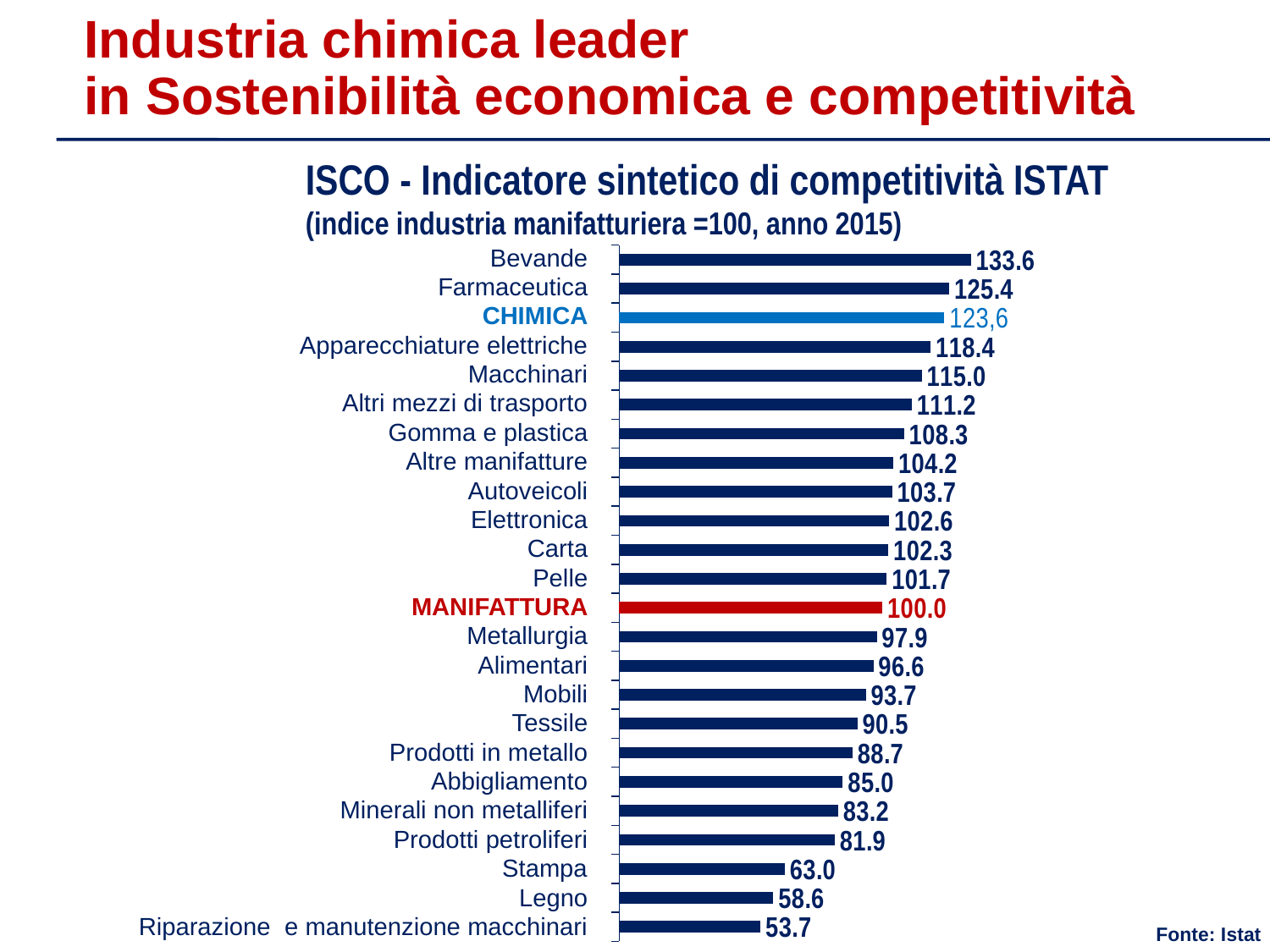
What is the ISCO value for Farmaceutica? 125.4 What is the difference between the values for Stampa and Legno? 4.4 What is the value for Prodotti petroliferi? 81.9 Which category's bar is coloured red? MANIFATTURA What is the difference between the values for Bevande and Farmaceutica? 8.2 Which has a larger value, Tessile or Mobili? Mobili What kind of chart is shown on the slide? Bar chart Which has a larger value, Macchinari or Autoveicoli? Macchinari What is the value shown for CHIMICA? 123,6 How many categories are shown in the chart? 24 Which category has the lowest value? Riparazione e manutenzione macchinari Which category has the highest value? Bevande